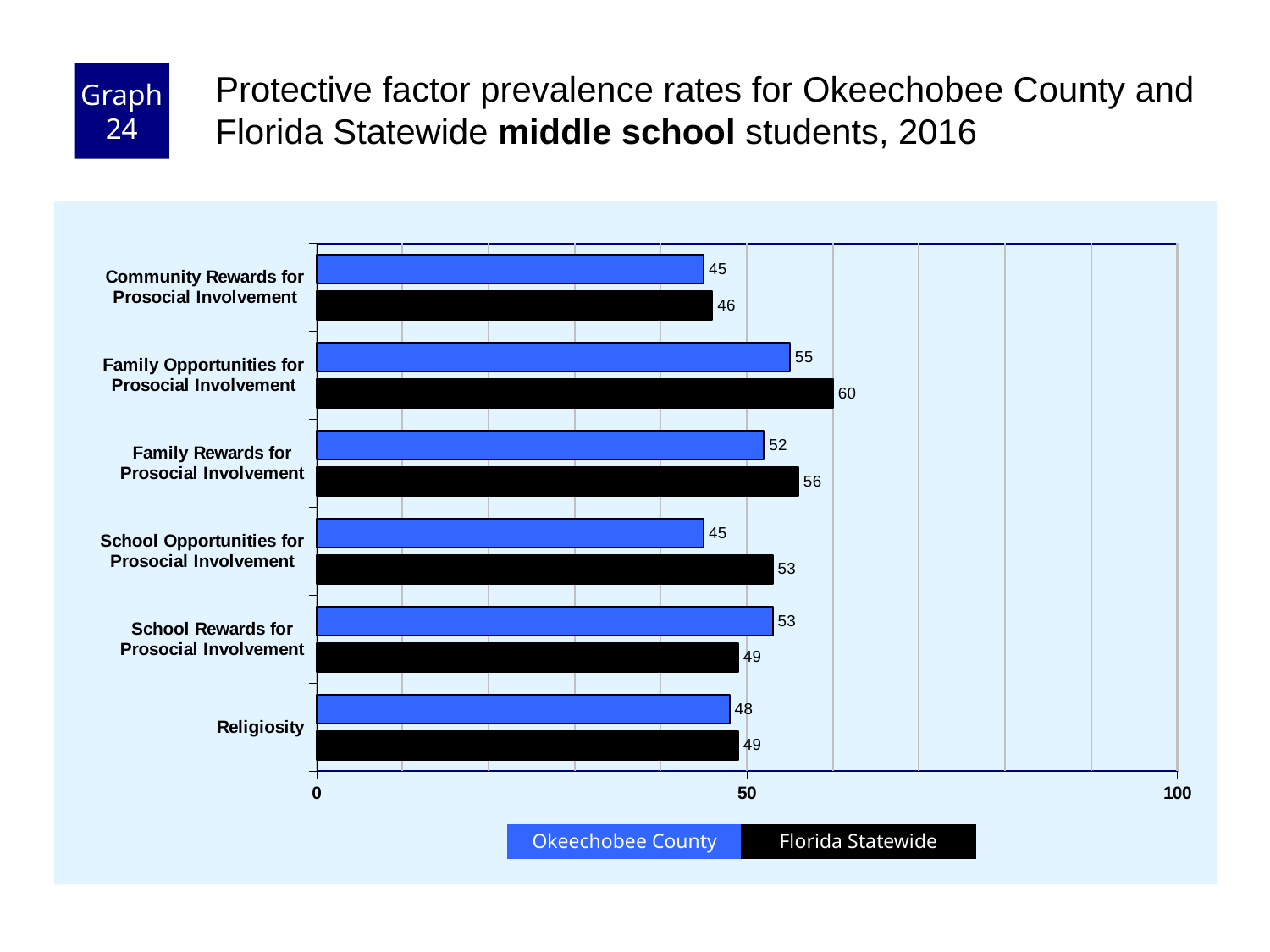
For School Rewards for Prosocial Involvement, which is larger: the Okeechobee County value or the Florida Statewide value? Okeechobee County How many protective factor categories are shown on the chart? 6 What kind of chart is shown on the slide? bar chart What is the Florida Statewide value for School Opportunities for Prosocial Involvement? 53 Is the Florida Statewide value for Family Opportunities for Prosocial Involvement greater or less than 50? greater Which category has the lowest Florida Statewide value? Community Rewards for Prosocial Involvement Which category has the highest Florida Statewide value? Family Opportunities for Prosocial Involvement Which series is shown in black in the legend? Florida Statewide How many series does the legend list? 2 What is the Okeechobee County value for Family Opportunities for Prosocial Involvement? 55 What is the difference between the Florida Statewide and Okeechobee County values for School Opportunities for Prosocial Involvement? 8 What is the Florida Statewide value for Religiosity? 49